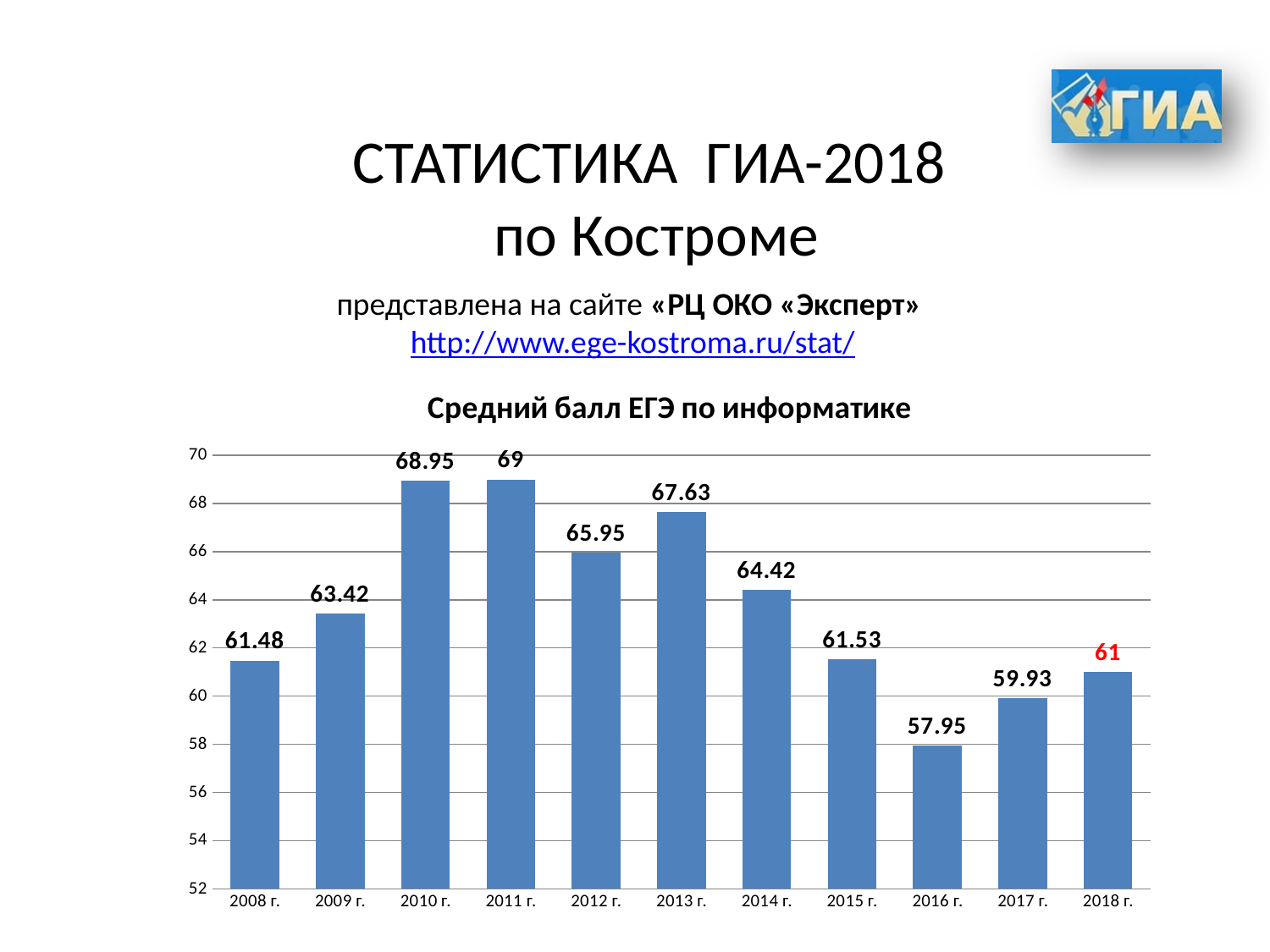
How many years are shown on the x axis? 11 Which year has the highest average score? 2011 г. What is the title of the chart? Средний балл ЕГЭ по информатике Do the values rise or fall from 2013 г. to 2016 г.? fall Which year has the lowest average score? 2016 г. What is the value shown for 2016 г.? 57.95 What kind of chart is shown on the slide? bar chart What is the value shown for 2010 г.? 68.95 What is the difference between the values for 2013 г. and 2014 г.? 3.21 Which is larger, the value for 2009 г. or the value for 2015 г.? 2009 г. Is the value for 2012 г. greater or less than 64? greater What is the average EGE score in informatics for 2018 г.? 61